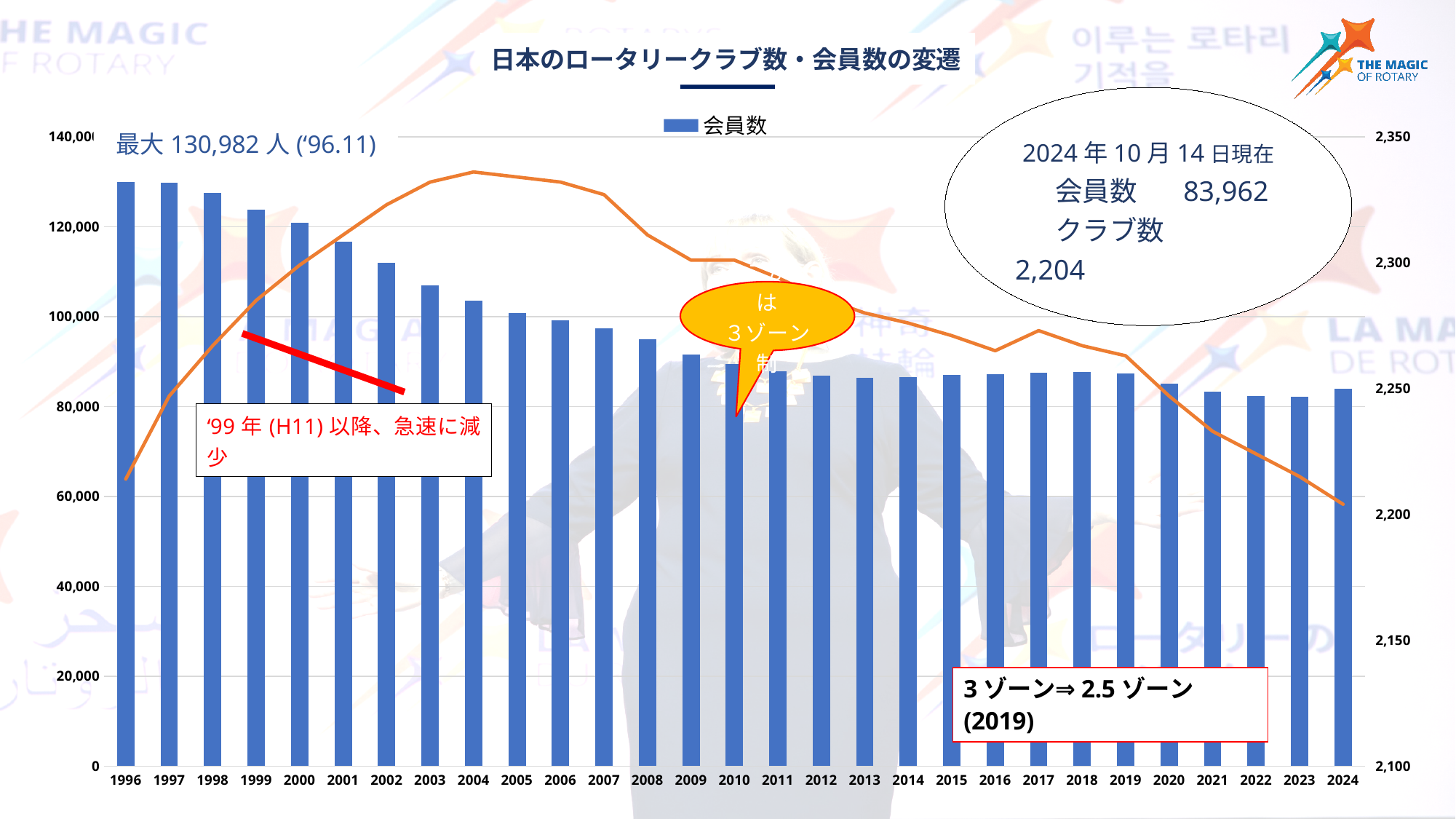
Is the 会員数 bar for 1996 greater or less than 120,000? greater Which year has the larger 会員数 bar, 2005 or 2015? 2005 What is the title of the chart? 日本のロータリークラブ数・会員数の変遷 Is the 会員数 bar for 2024 greater or less than 100,000? less How many years are plotted along the x axis of the chart? 29 How many series does the chart legend list? 1 What series name appears in the chart legend? 会員数 What kind of chart is shown on the slide? bar chart (with a line overlay) According to the annotation on the chart, what was the peak membership (最大)? 130,982 人 Do the 会員数 bars generally rise or fall from 1996 to 2010? fall According to the text box on the chart, what is the 会員数 as of 2024年10月14日? 83,962 According to the text box on the chart, what is the クラブ数 as of 2024年10月14日? 2,204